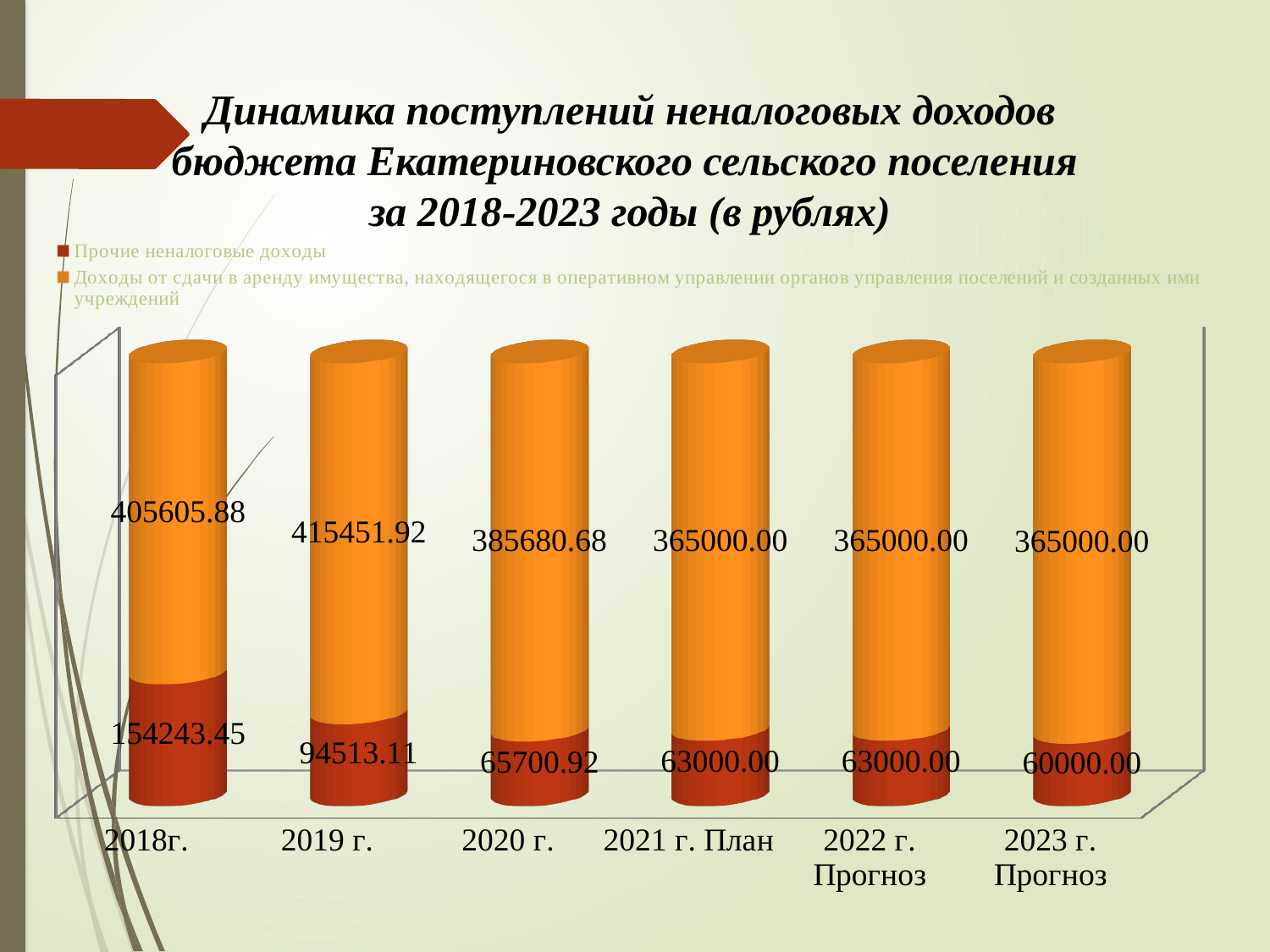
In which year is 'Доходы от сдачи в аренду имущества...' the highest? 2019 г. What is the value of 'Прочие неналоговые доходы' for 2023 г. Прогноз? 60000.00 In which year is 'Прочие неналоговые доходы' the lowest? 2023 г. Прогноз How many series does the legend list? 2 What is the difference between 'Прочие неналоговые доходы' in 2018г. and 2019 г.? 59730.34 What is the value of 'Прочие неналоговые доходы' for 2018г.? 154243.45 How many categories (years) are shown on the x axis? 6 What kind of chart is shown on the slide? bar chart Does 'Прочие неналоговые доходы' rise or fall from 2018г. to 2023 г. Прогноз? fall What is the value of 'Доходы от сдачи в аренду имущества...' for 2019 г.? 415451.92 What is the total of the two series for 2021 г. План? 428000.00 Which is larger: 'Доходы от сдачи в аренду имущества...' in 2020 г. or in 2021 г. План? 2020 г.